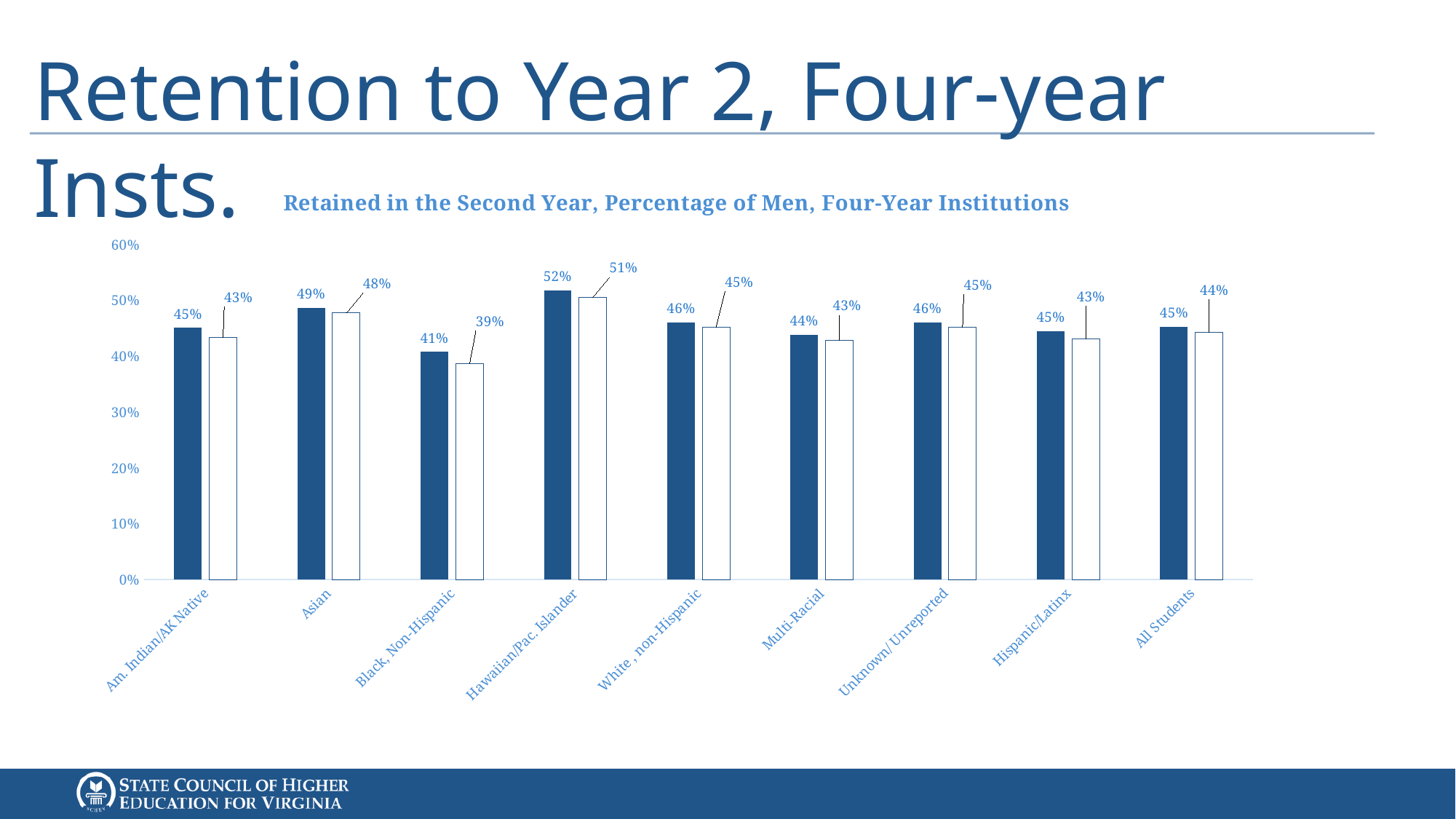
What is the difference between the solid dark blue bar and the white outlined bar for Am. Indian/AK Native? 2% What is the difference between the solid dark blue bars for Hawaiian/Pac. Islander and Black, Non-Hispanic? 11% What is the value of the solid dark blue bar for Asian? 49% Is the white outlined bar for Black, Non-Hispanic greater or less than 40%? less What type of chart is shown on the slide? Bar chart Which is larger, the solid dark blue bar for Asian or the solid dark blue bar for Multi-Racial? Asian Which category has the lowest white outlined bar? Black, Non-Hispanic What is the value of the solid dark blue bar for All Students? 45% What is the value of the white outlined bar for Hawaiian/Pac. Islander? 51% What is the value of the white outlined bar for Black, Non-Hispanic? 39% How many categories are shown on the x axis? 9 Which category has the highest solid dark blue bar? Hawaiian/Pac. Islander